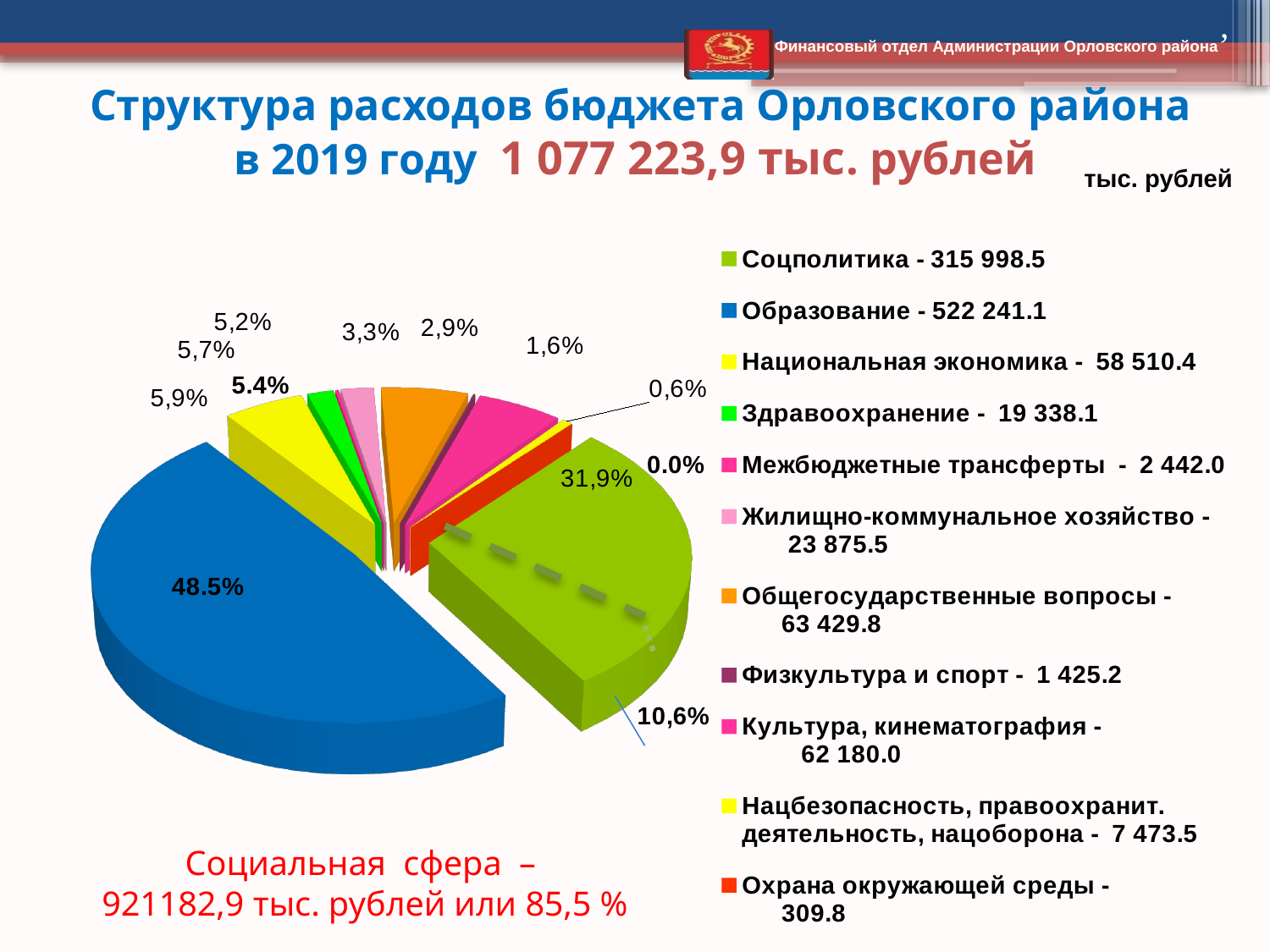
What value is given in the legend for Образование? 522 241.1 Which is larger: Общегосударственные вопросы or Культура, кинематография? Общегосударственные вопросы What value is given in the legend for Здравоохранение? 19 338.1 Which category has the largest value in the pie chart? Образование What total budget expenditure amount is stated in the slide title? 1 077 223,9 тыс. рублей What percentage label is shown on the largest (blue) slice of the pie chart? 48.5% How many categories does the legend of the pie chart list? 11 What value is given in the legend for Соцполитика? 315 998.5 What type of chart is shown on the slide? pie chart What is the difference between the values for Образование and Соцполитика? 206 242.6 What value is given in the legend for Физкультура и спорт? 1 425.2 Which category has the smallest value in the pie chart? Охрана окружающей среды